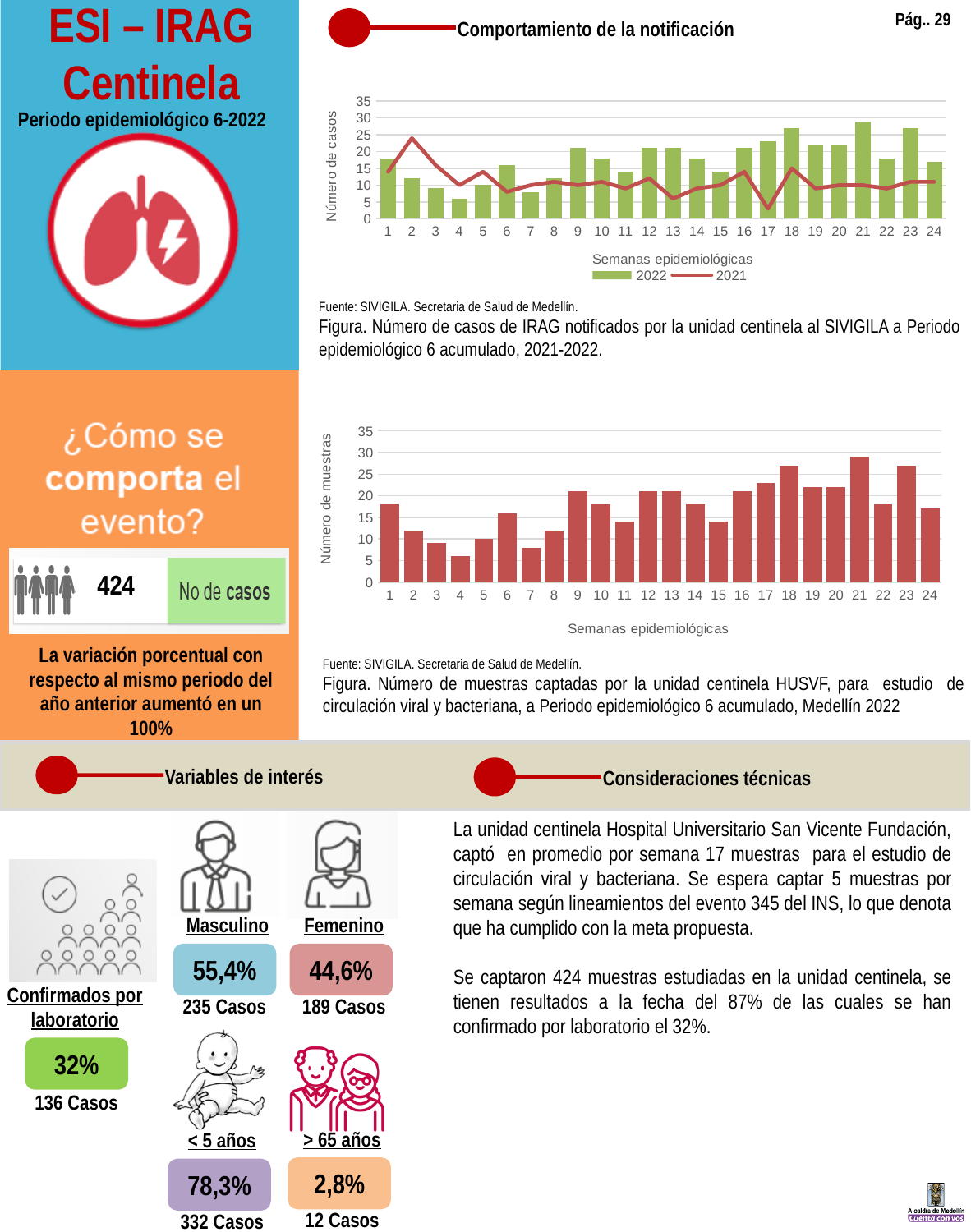
How many epidemiological weeks are shown on the x axis of the bottom chart? 24 In the top chart, what are the two legend entries? 2022 and 2021 In the top chart, which epidemiological week has the highest 2022 bar? 21 In the top chart, is the 2021 value for week 17 greater or less than 10? less In the top chart, is the 2021 value for week 2 greater or less than 20? greater In the top chart, in which week does the 2021 line reach its highest value? 2 In the bottom chart, do the values rise or fall from week 1 to week 4? fall In the bottom chart, which is larger, the value for week 18 or the value for week 19? week 18 What kind of chart is the bottom chart (Número de muestras)? bar chart In the top chart (Comportamiento de la notificación), how many series does the legend list? 2 In the top chart, which epidemiological week has the lowest 2022 bar? 4 In the bottom chart, is the value for week 21 greater or less than 25? greater